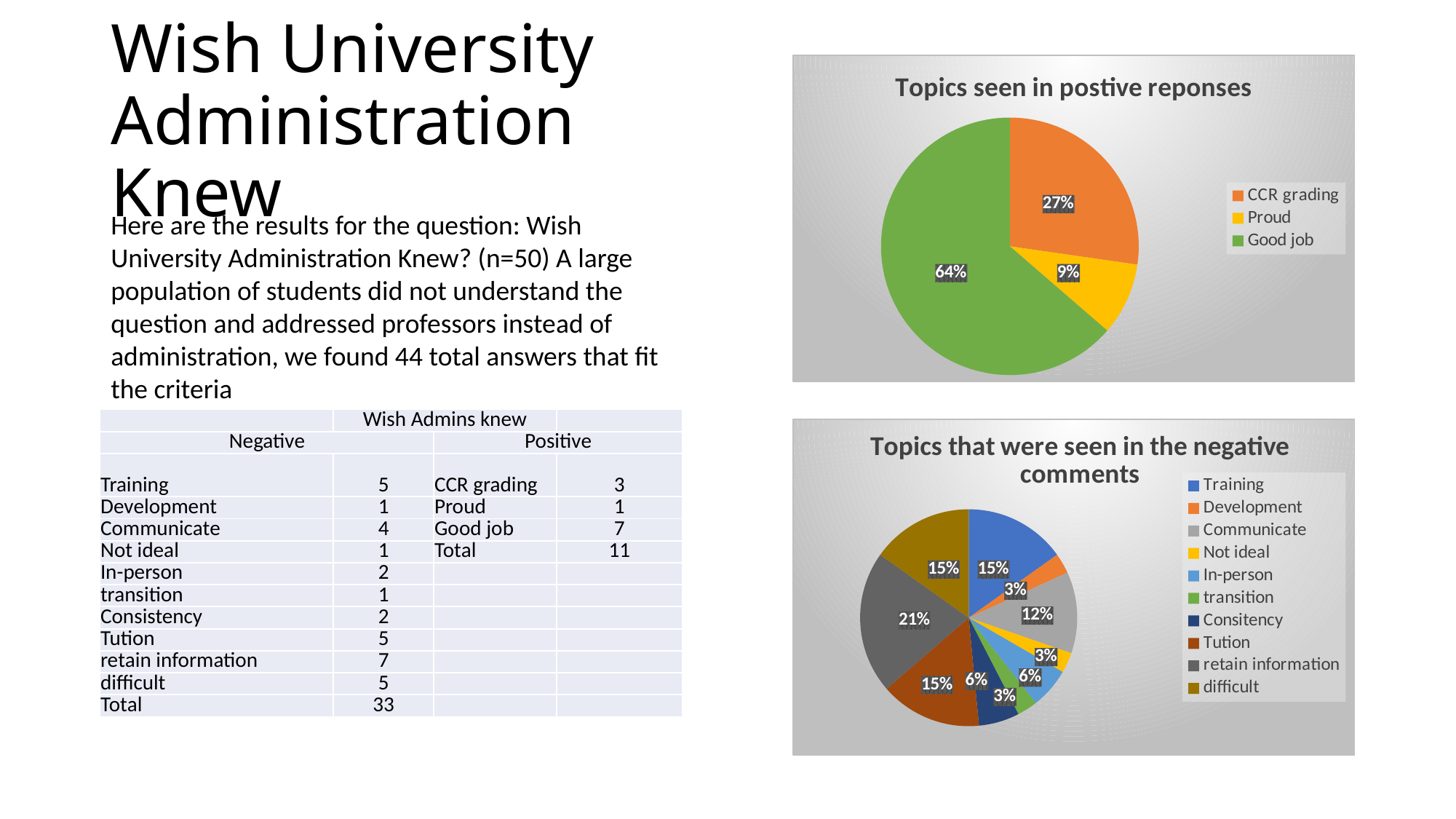
In the 'Topics seen in postive reponses' chart, which category has the largest slice? Good job In the 'Topics that were seen in the negative comments' chart, what percentage is labelled for retain information? 21% In the 'Topics seen in postive reponses' chart, how many categories does the legend list? 3 In the 'Topics seen in postive reponses' chart, what percentage is labelled for CCR grading? 27% In the 'Topics that were seen in the negative comments' chart, how many categories does the legend list? 10 In the 'Topics seen in postive reponses' chart, what share of the pie is Good job? 64% In the 'Topics seen in postive reponses' chart, what is the difference in percentage points between Good job and CCR grading? 37 In the 'Topics that were seen in the negative comments' chart, which is larger, Communicate or In-person? Communicate In the 'Topics seen in postive reponses' chart, which category has the smallest slice? Proud What type of chart is 'Topics that were seen in the negative comments'? Pie chart In the 'Topics that were seen in the negative comments' chart, what percentage is labelled for Communicate? 12% In the 'Topics that were seen in the negative comments' chart, which category has the largest slice? retain information